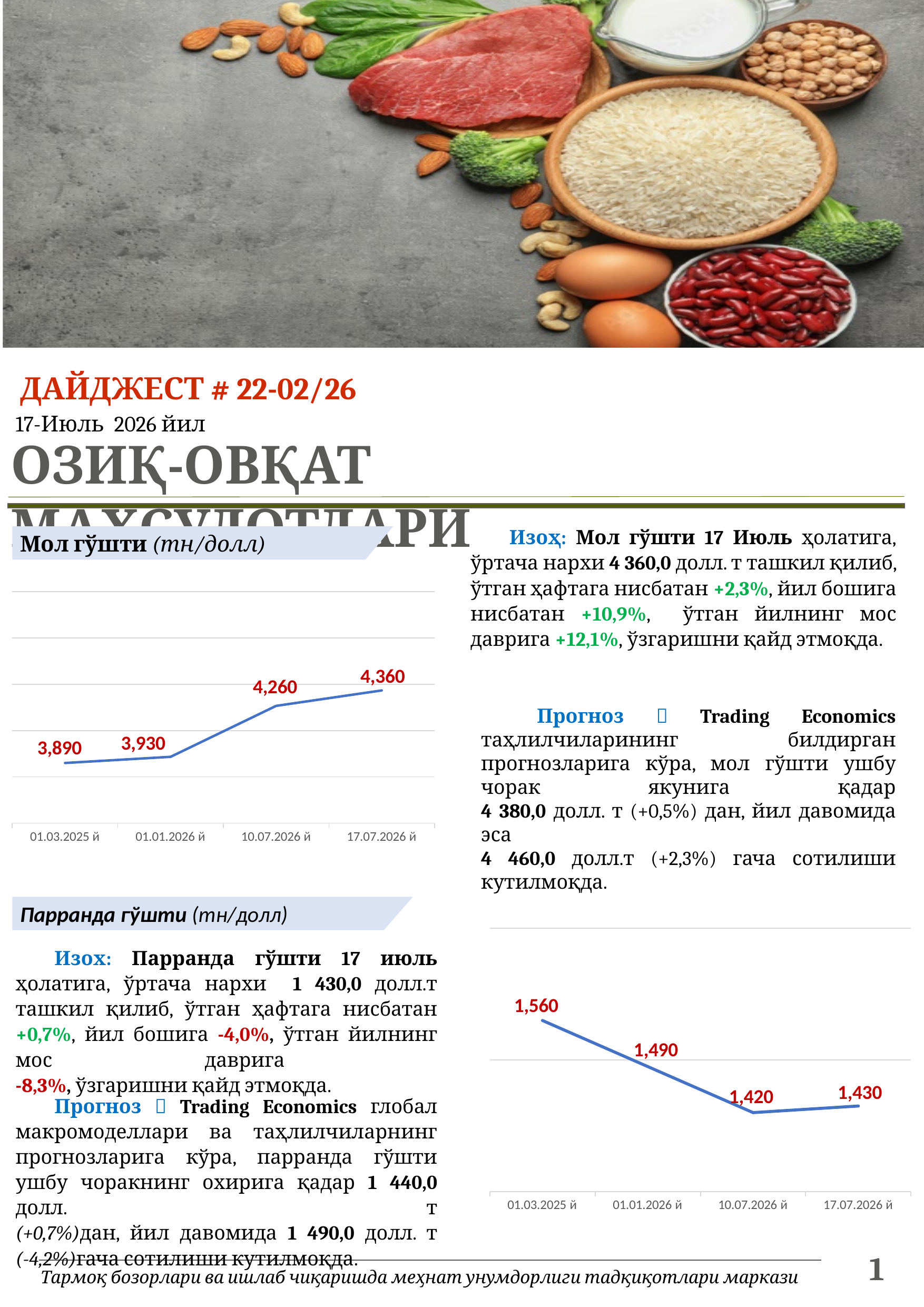
In the "Мол гўшти (тн/долл)" chart, what is the value for 01.03.2025 й? 3,890 How many data points are plotted in the "Мол гўшти (тн/долл)" chart? 4 In the "Парранда гўшти (тн/долл)" chart, which is larger: the value for 01.03.2025 й or the value for 01.01.2026 й? 01.03.2025 й In the "Парранда гўшти (тн/долл)" chart, which date has the lowest value? 10.07.2026 й In the "Мол гўшти (тн/долл)" chart, which is larger: the value for 01.01.2026 й or the value for 10.07.2026 й? 10.07.2026 й In the "Мол гўшти (тн/долл)" chart, what is the value for 17.07.2026 й? 4,360 In the "Парранда гўшти (тн/долл)" chart, what is the value for 01.01.2026 й? 1,490 In the "Мол гўшти (тн/долл)" chart, do the values rise or fall from left to right? rise In the "Парранда гўшти (тн/долл)" chart, what is the difference between the values for 01.03.2025 й and 17.07.2026 й? 130 In the "Мол гўшти (тн/долл)" chart, which date has the highest value? 17.07.2026 й What kind of chart is the "Парранда гўшти (тн/долл)" chart? line chart In the "Мол гўшти (тн/долл)" chart, what is the difference between the values for 17.07.2026 й and 10.07.2026 й? 100